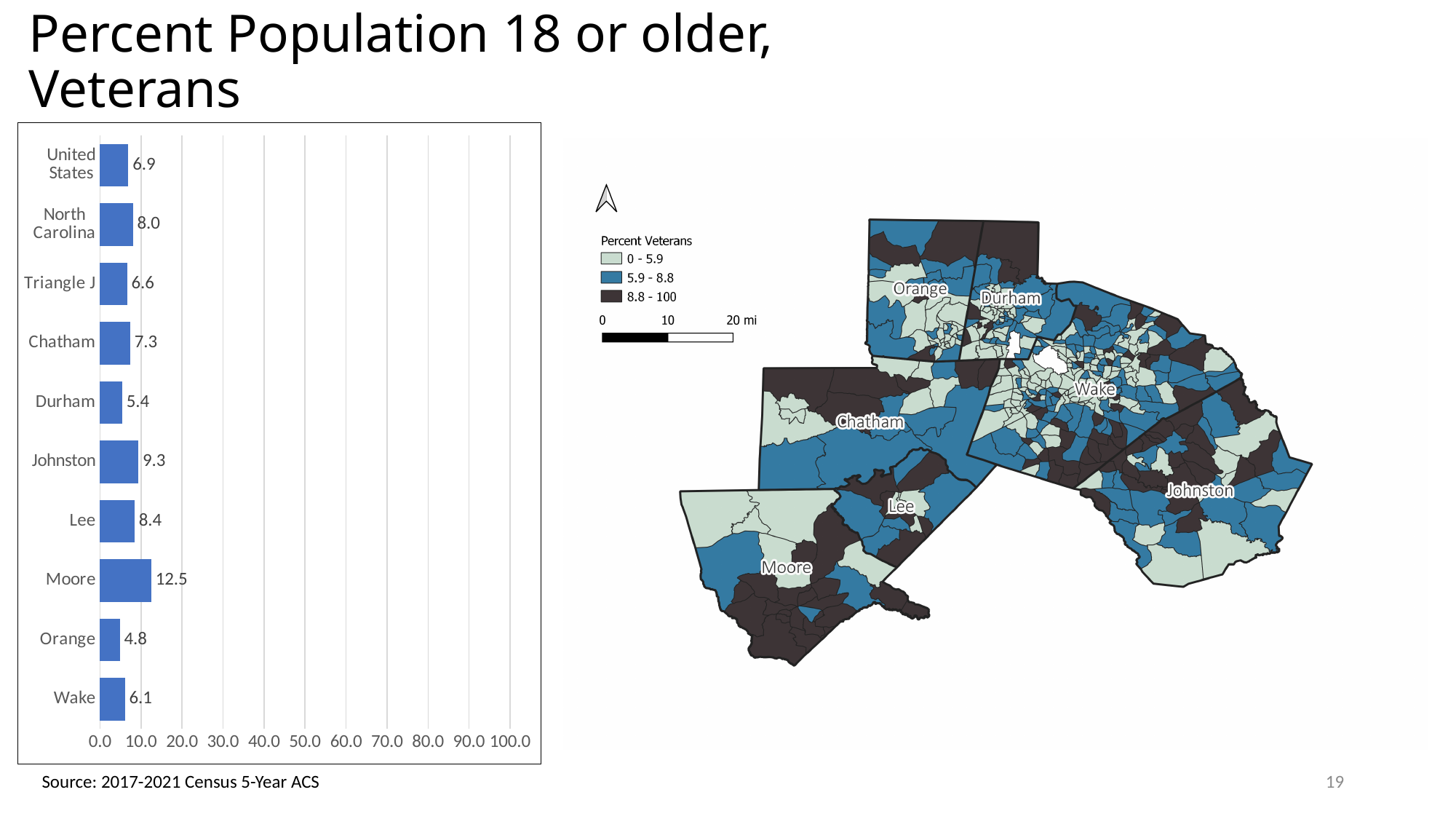
How many categories are shown in the bar chart? 10 Which category has the highest value in the bar chart? Moore What is the value for Durham in the bar chart? 5.4 What is the difference between the values for United States and Triangle J in the bar chart? 0.3 Which has a larger value in the bar chart, Johnston or Lee? Johnston What is the value for Moore in the bar chart? 12.5 What is the value for North Carolina in the bar chart? 8.0 What is the difference between the values for Moore and Orange in the bar chart? 7.7 Which category has the lowest value in the bar chart? Orange Is the value for Wake in the bar chart greater or less than 10.0? less What kind of chart is shown on the left of the slide? bar chart How many ranges does the map legend for Percent Veterans list? 3